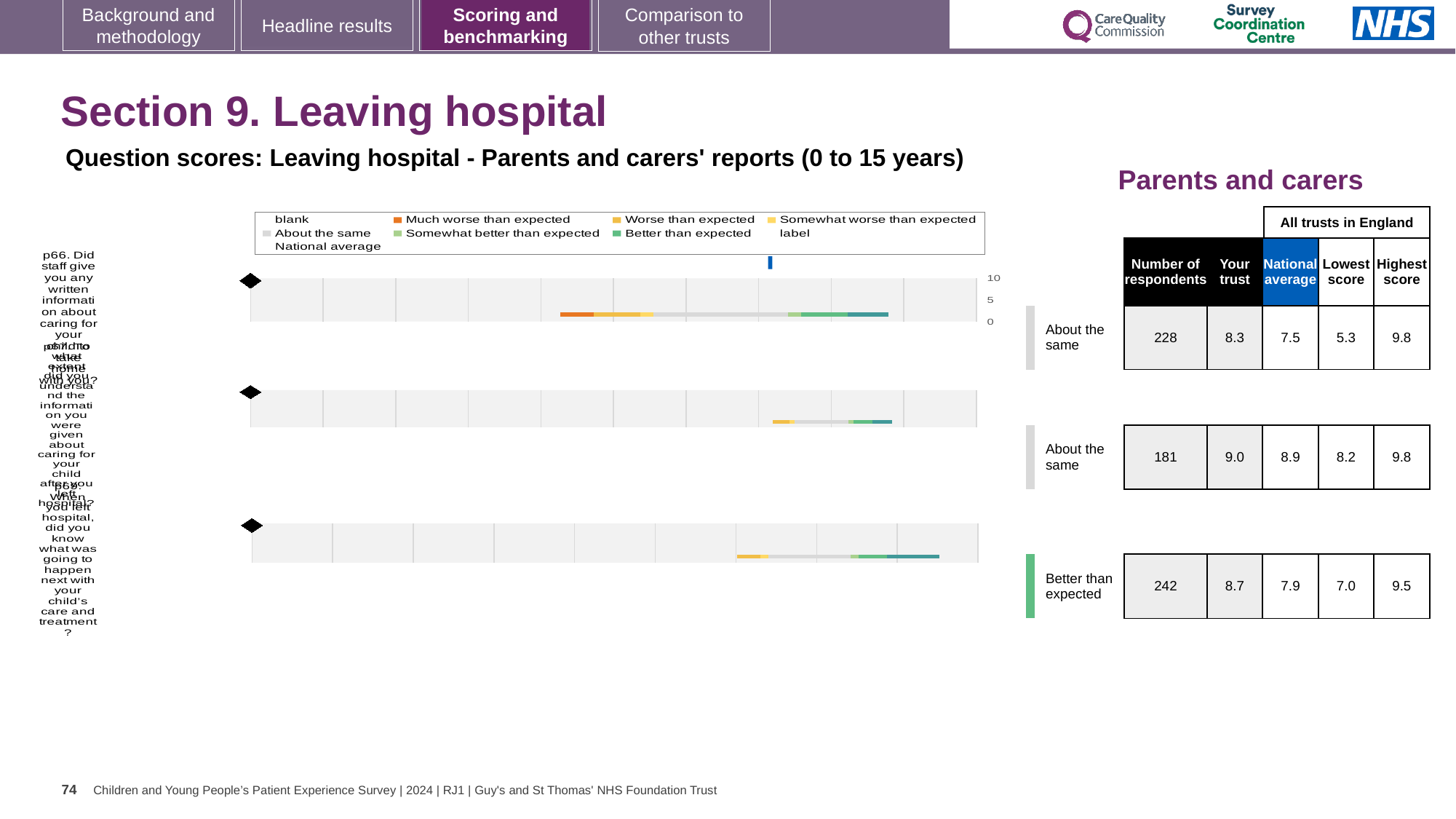
Which of the three charts is labelled 'Better than expected' in the table? The bottom chart (p68) How many entries does the legend above the charts list? 9 Which of the three charts has the highest 'Your trust' score? The middle chart (p67) For the bottom chart (p68), what is the national average score shown in the table? 7.9 What is the highest tick value shown on the score axis of the top chart? 10 For the top chart (p66), which is larger: the 'Your trust' score or the national average? Your trust For the middle chart (p67), how many respondents are shown in the table? 181 For the bottom chart (p68), what is the difference between the highest score and the lowest score in the table? 2.5 For the top chart (p66), what is the 'Your trust' score shown in the table? 8.3 What kind of chart is used to show the question scores on this slide? Bar chart In the legend, what colour represents 'Much worse than expected'? Orange How many question-score charts are shown on the slide? 3